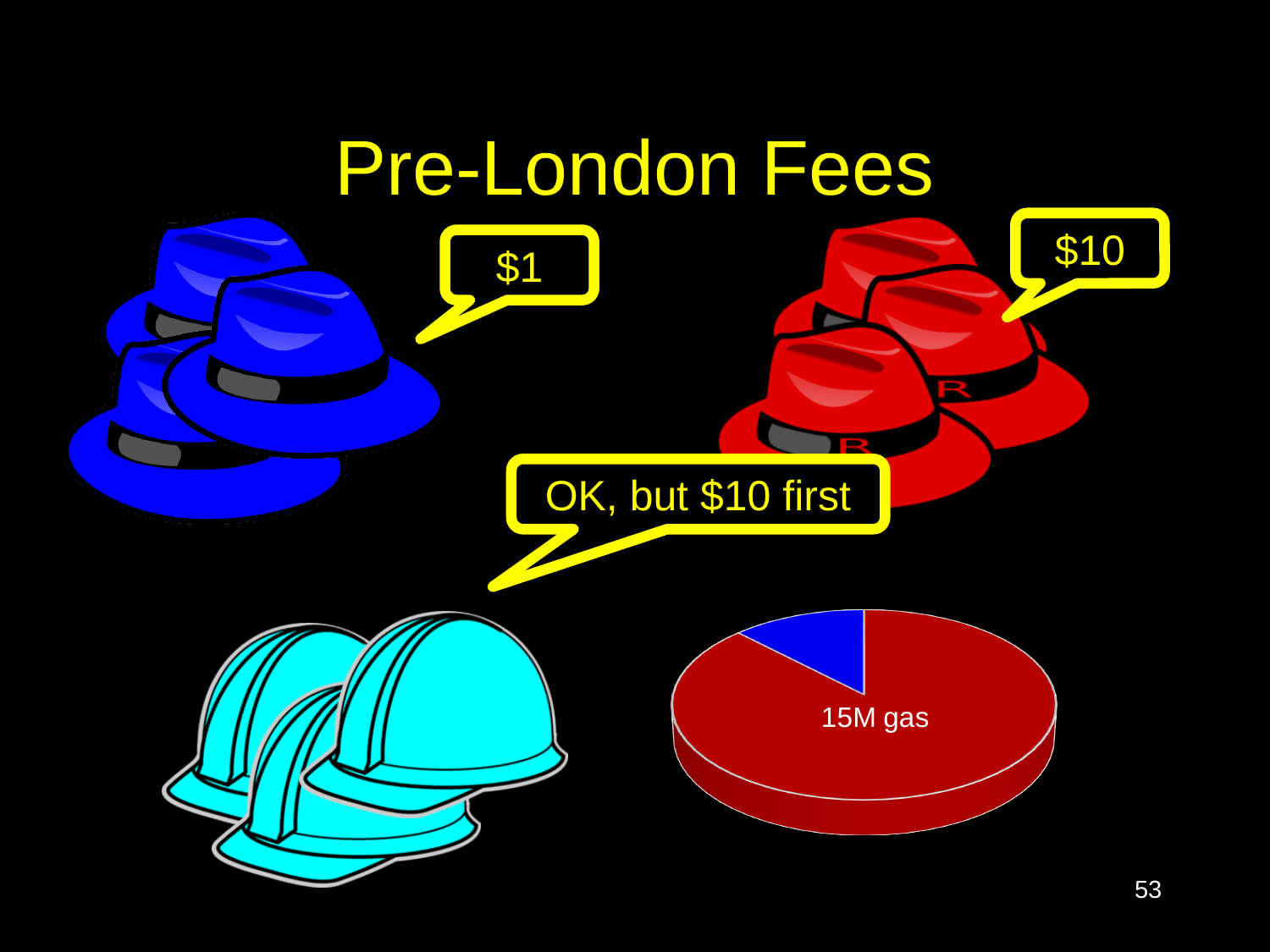
Which colour slice is the largest in the pie chart? red Is the red slice of the pie chart greater or less than half of the pie? greater How many slices does the pie chart have? 2 Which colour slice is the smallest in the pie chart? blue What is the title of the slide containing the pie chart? Pre-London Fees What kind of chart is shown at the bottom right of the slide? pie chart Which slice of the pie chart is larger, the red one or the blue one? red Is the blue slice of the pie chart greater or less than a quarter of the pie? less Does the pie chart have a legend? No What label is printed on the red slice of the pie chart? 15M gas